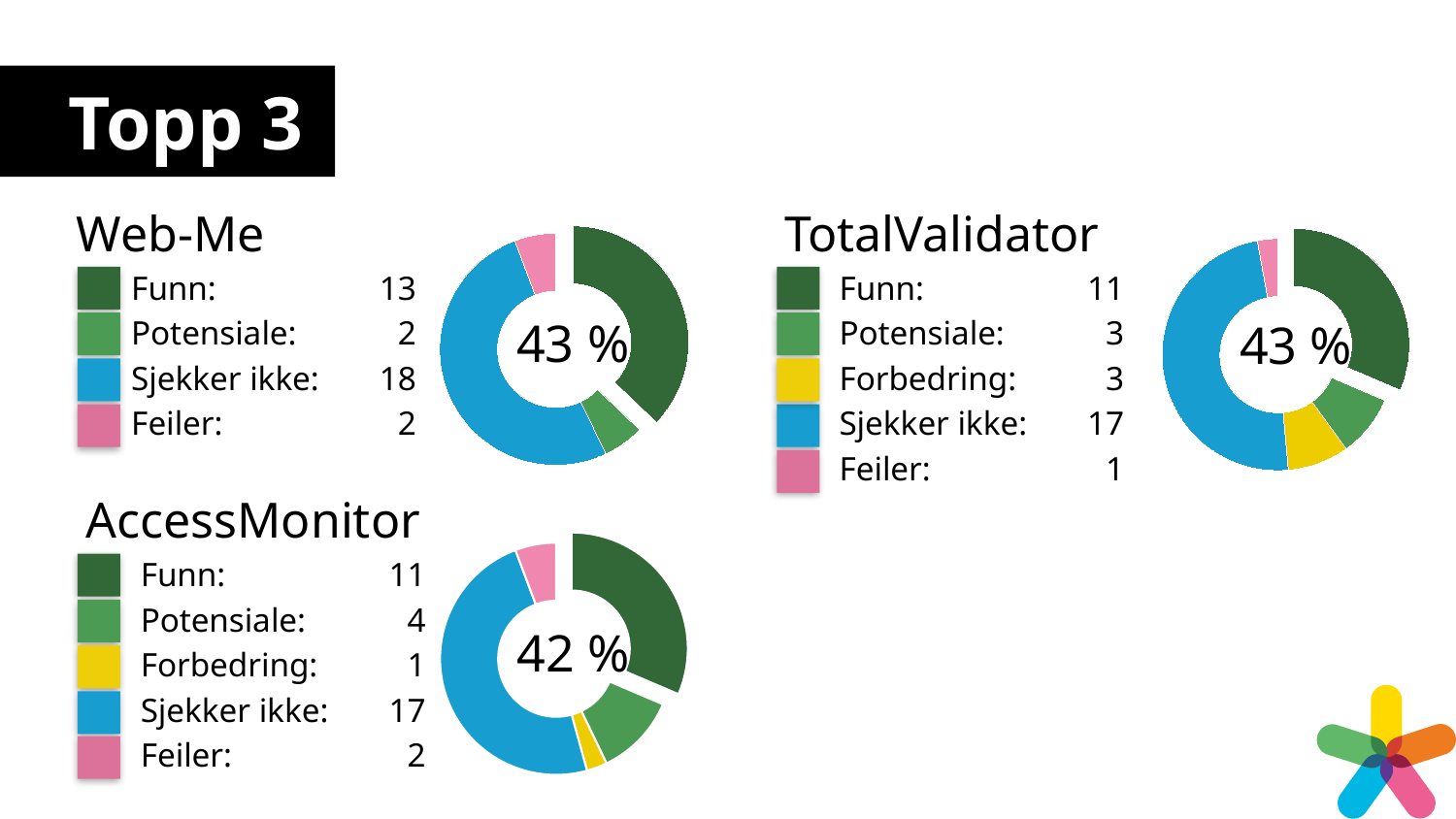
In the Web-Me chart, what is the value for Sjekker ikke? 18 In the AccessMonitor chart, what is the value for Potensiale? 4 In the Web-Me chart, what is the difference between Sjekker ikke and Funn? 5 In the Web-Me chart, which category has the highest value? Sjekker ikke How many categories does the TotalValidator chart's legend list? 5 In the AccessMonitor chart, which category has the lowest value? Forbedring In the TotalValidator chart, which category has the lowest value? Feiler In the TotalValidator chart, what is the total of all categories? 35 What percentage is shown in the centre of the AccessMonitor chart? 42 % In the AccessMonitor chart, which is larger, Funn or Potensiale? Funn In the TotalValidator chart, what is the value for Funn? 11 What kind of chart is used for Web-Me? Donut chart